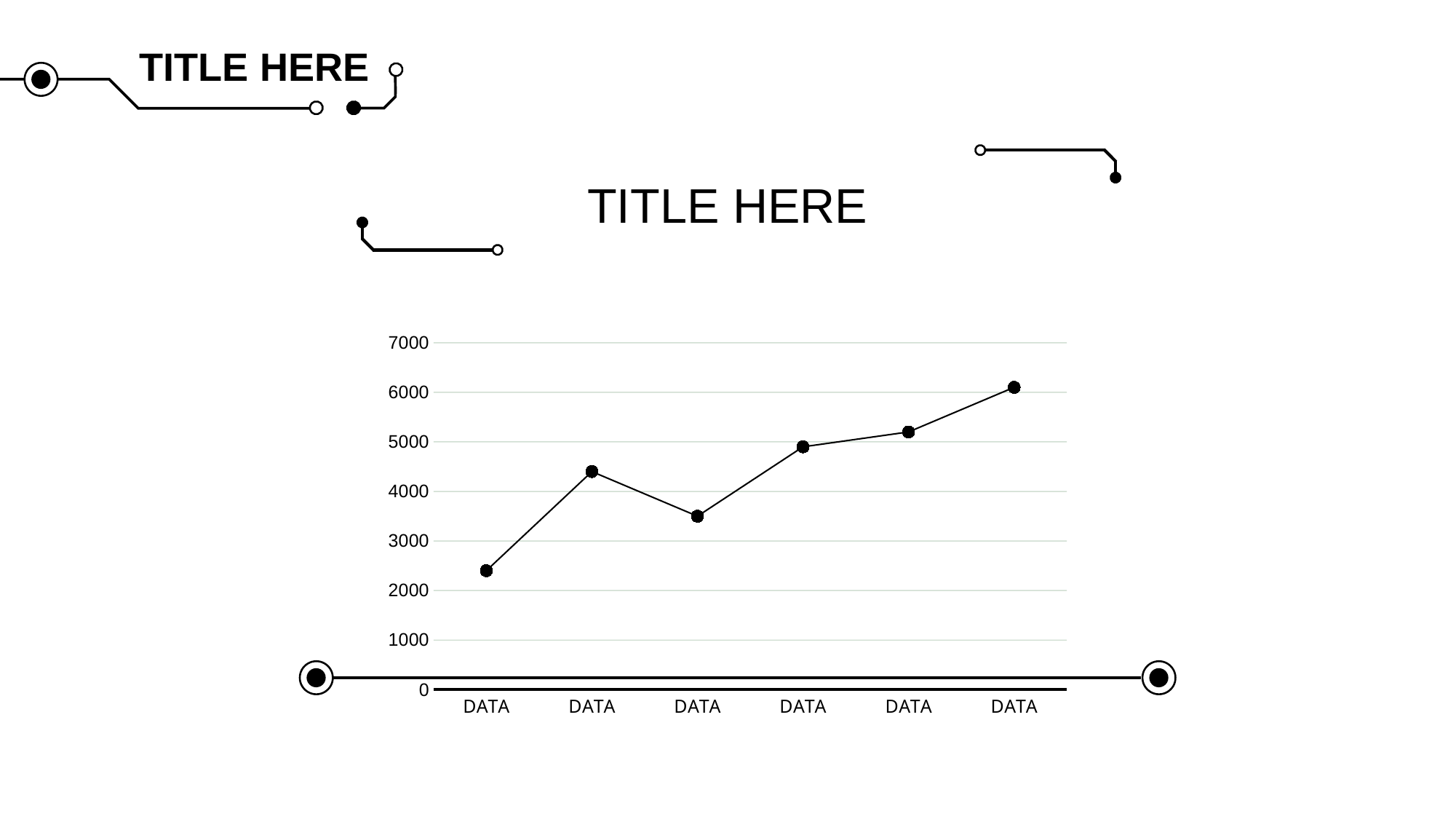
Which is larger, the value of the second DATA point or the third DATA point? the second DATA point Overall, do the values rise or fall from the first point to the last point along the x axis? rise Is the value of the last DATA point greater or less than 5000? greater Which point on the line chart has the highest value? the sixth (last) DATA point Is the value of the second DATA point greater or less than 4000? greater What is the title shown above the chart? TITLE HERE Is the value of the third DATA point greater or less than 4000? less Which point on the line chart has the lowest value? the first DATA point How many data points are plotted on the line chart? 6 What kind of chart is shown on the slide? line chart